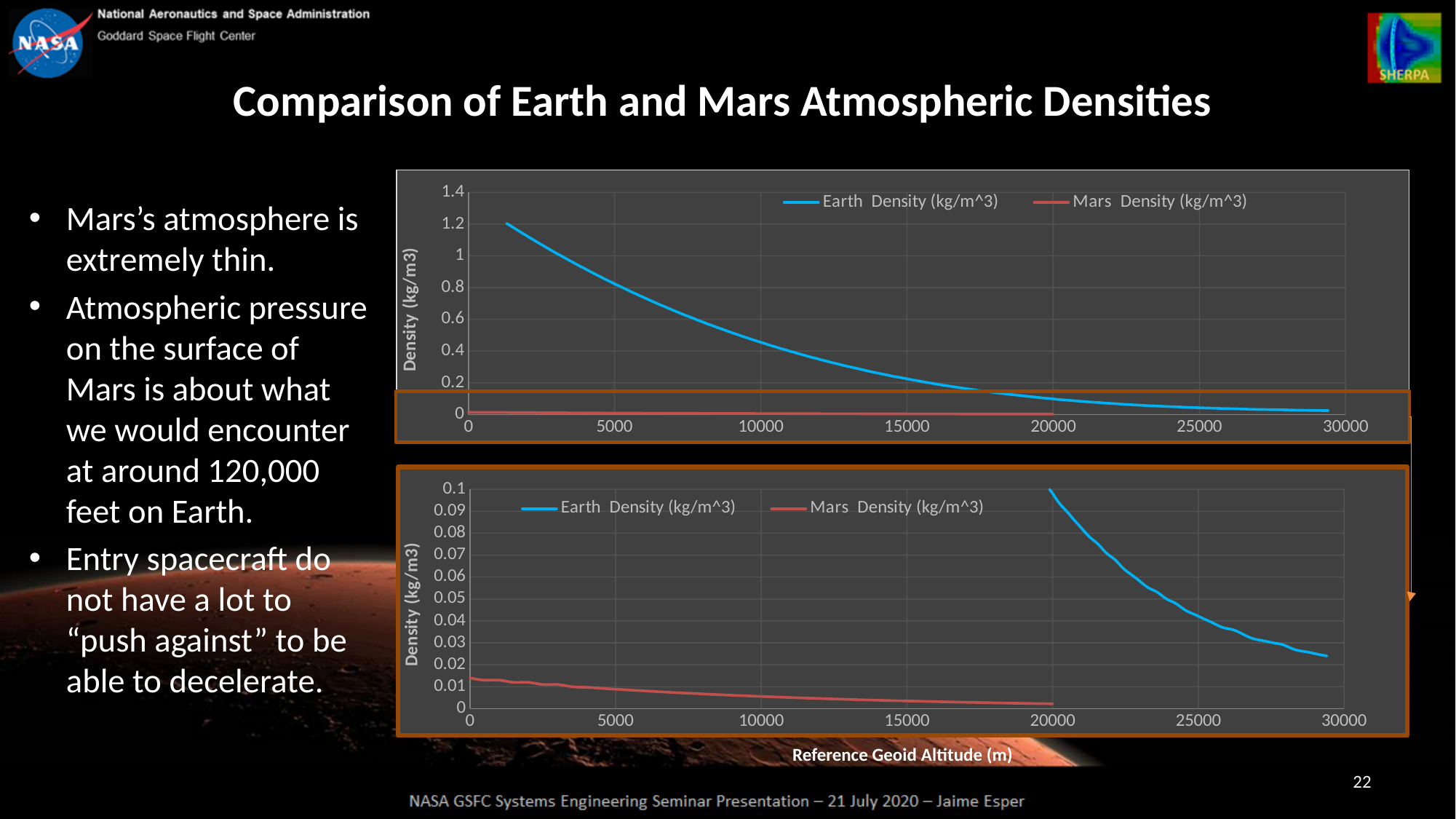
What kind of chart is the top chart on the slide? line chart In the bottom chart, is the Mars density at 20000 m greater or less than 0.01? less In the bottom chart, is the Mars density at 0 m greater or less than 0.01? greater How many series does the legend of the top chart list? 2 In the top chart, which series has the larger density at 10000 m, Earth or Mars? Earth In the top chart, is the Earth density at 10000 m greater or less than 0.6? less What is the x-axis title shown below the bottom chart? Reference Geoid Altitude (m) In the top chart, does Earth density rise or fall as the reference geoid altitude increases? fall In the bottom chart, does Mars density rise or fall as altitude increases from 0 to 20000 m? fall